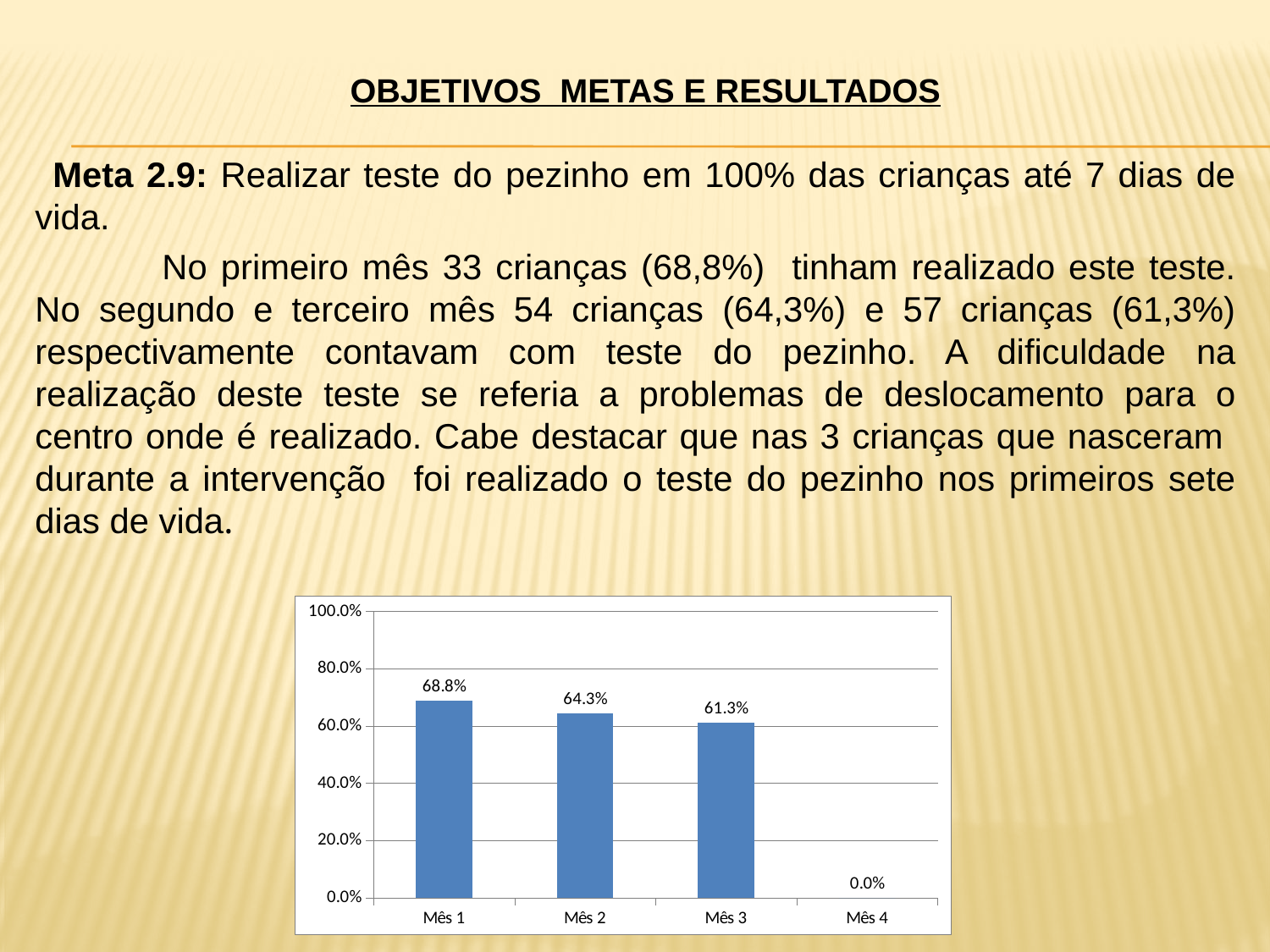
Which is larger, the value for Mês 2 or the value for Mês 3? Mês 2 How many categories are shown on the x axis? 4 What is the value for Mês 4? 0.0% Which category has the highest value? Mês 1 What is the value for Mês 2? 64.3% Is the value for Mês 1 greater or less than 60.0%? greater What is the value for Mês 1? 68.8% What is the value for Mês 3? 61.3% What kind of chart is shown on the slide? bar chart Do the values rise or fall from Mês 1 to Mês 3? fall Which category has the lowest value? Mês 4 What is the difference between the values for Mês 1 and Mês 3? 7.5%